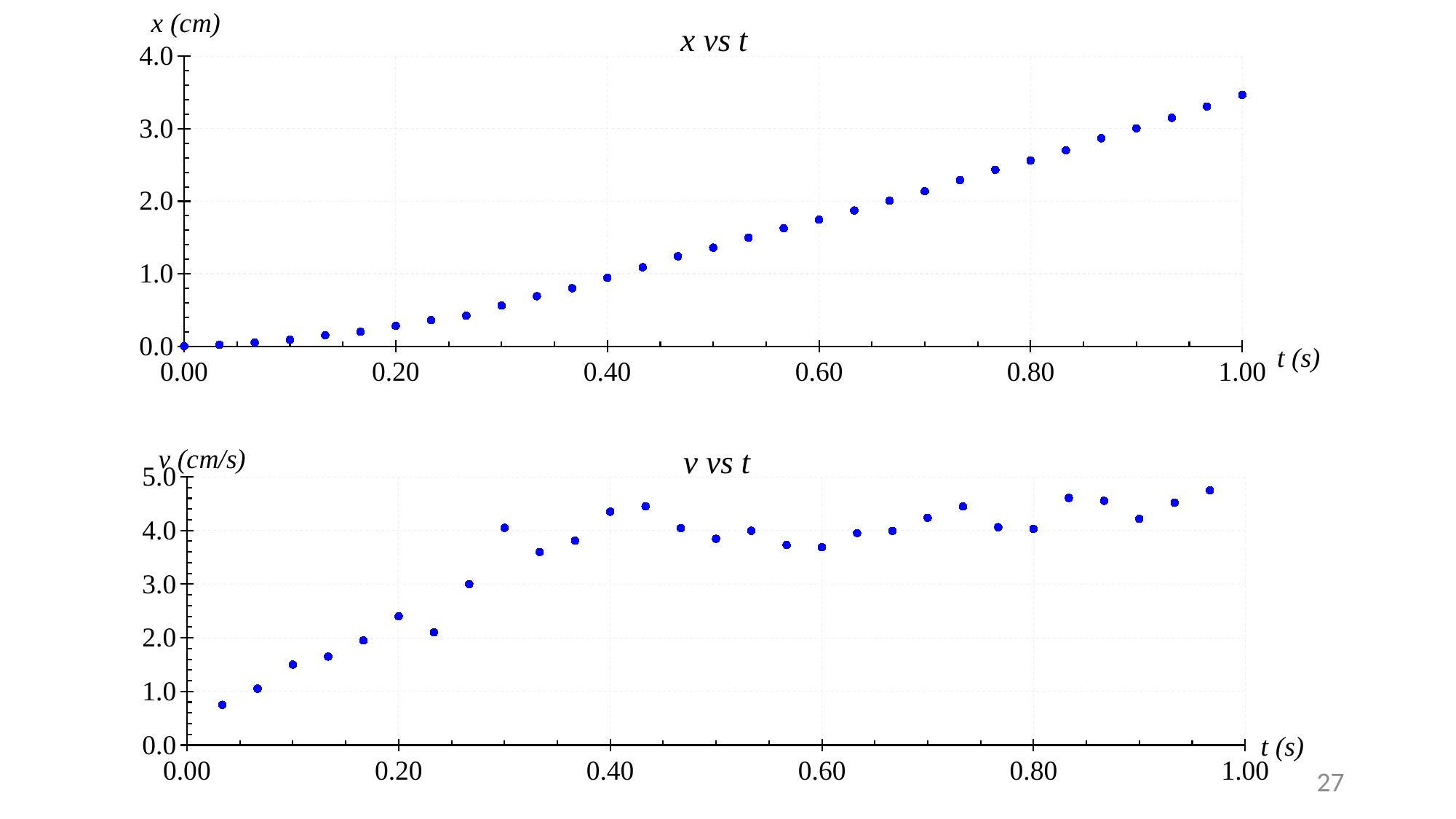
In the "x vs t" chart, is the value of x at t = 0.80 s greater or less than 2.0? greater What is the title of the top chart? x vs t In the "v vs t" chart, is the value of v at t = 0.40 s greater or less than 4.0? greater What kind of chart is the "x vs t" chart? scatter chart In the "v vs t" chart, is the lowest value of v at the first point or the last point? the first point In the "v vs t" chart, is the value of v at t = 0.60 s greater or less than 4.0? less In the "x vs t" chart, do the values rise or fall as t increases? rise What is the y-axis label of the bottom chart? v (cm/s) In the "x vs t" chart, at which value of t is x highest? 1.00